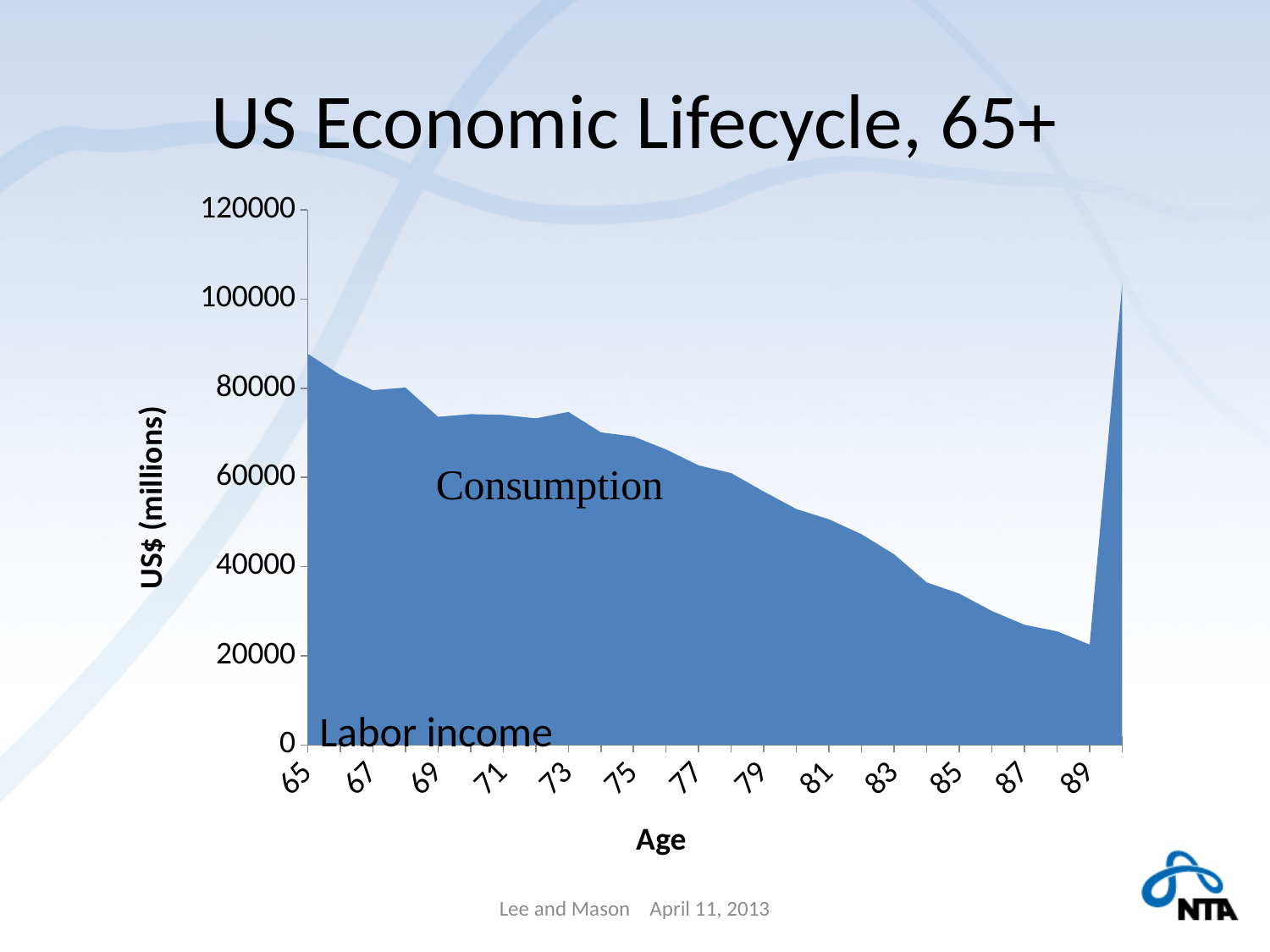
What is the title of the chart? US Economic Lifecycle, 65+ At which labeled age is the consumption value lowest? 89 What kind of chart is shown on the slide? area chart What is the label on the vertical axis of the chart? US$ (millions) Do consumption values rise or fall as age increases from 65 to 89? fall How many age labels are shown on the x axis? 13 Is the consumption value at age 65 greater or less than 80000? greater Is the consumption value at age 75 greater or less than 60000? greater Is the consumption value at age 89 greater or less than 40000? less Which is larger, the consumption value at age 65 or at age 85? age 65